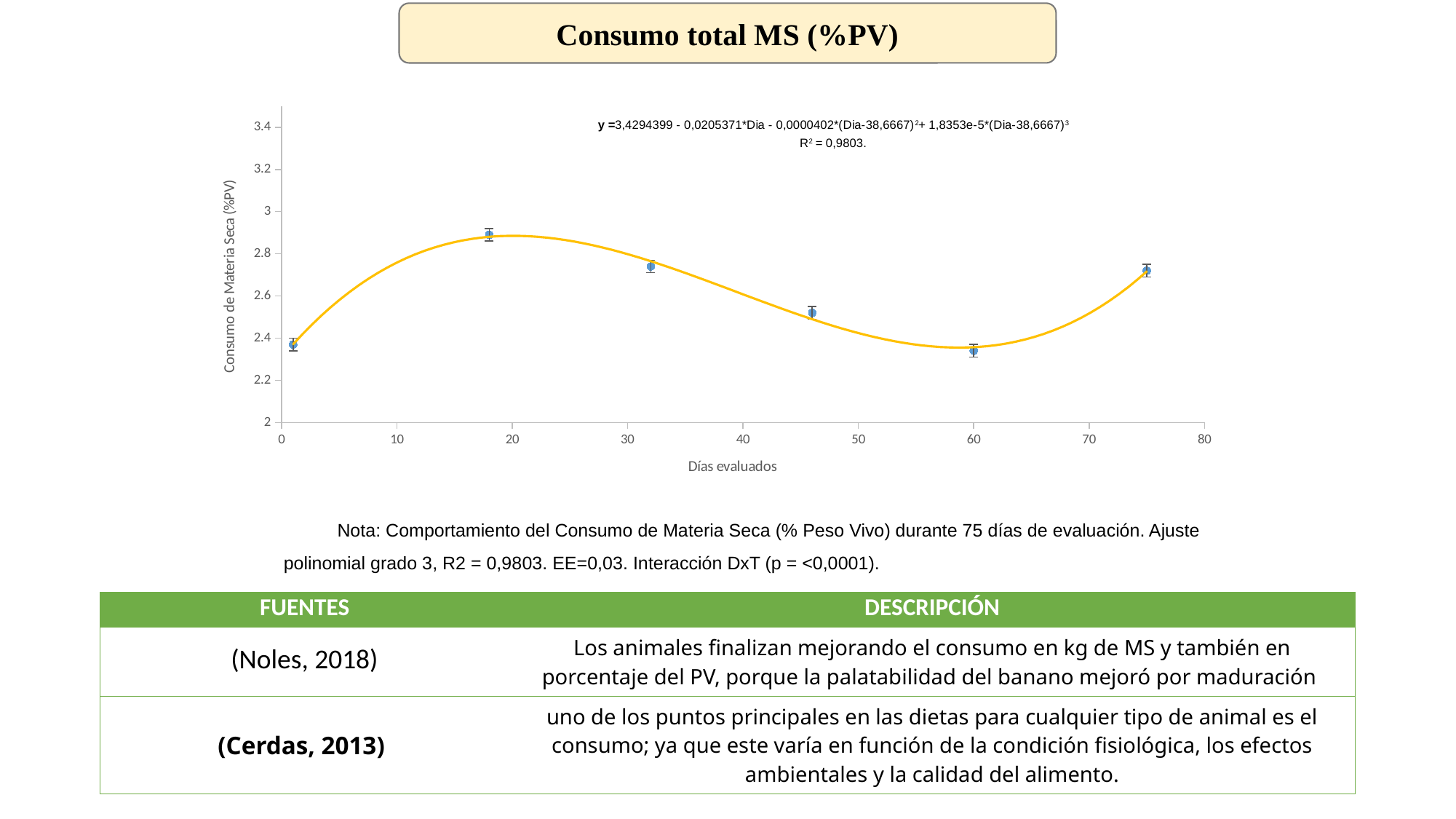
Is the value at day 1 greater or less than 2.6? less Is the value at day 60 greater or less than 2.4? less Is the value at day 75 greater or less than 2.8? less How many data points are plotted on the chart? 6 Which has a higher dry matter consumption, day 18 or day 32? Day 18 Between day 18 and day 60, do the plotted values rise or fall? Fall What kind of chart is shown on the slide? Scatter plot with a fitted curve What R² value is shown on the chart for the fitted curve? 0,9803 Which has a higher dry matter consumption, day 46 or day 75? Day 75